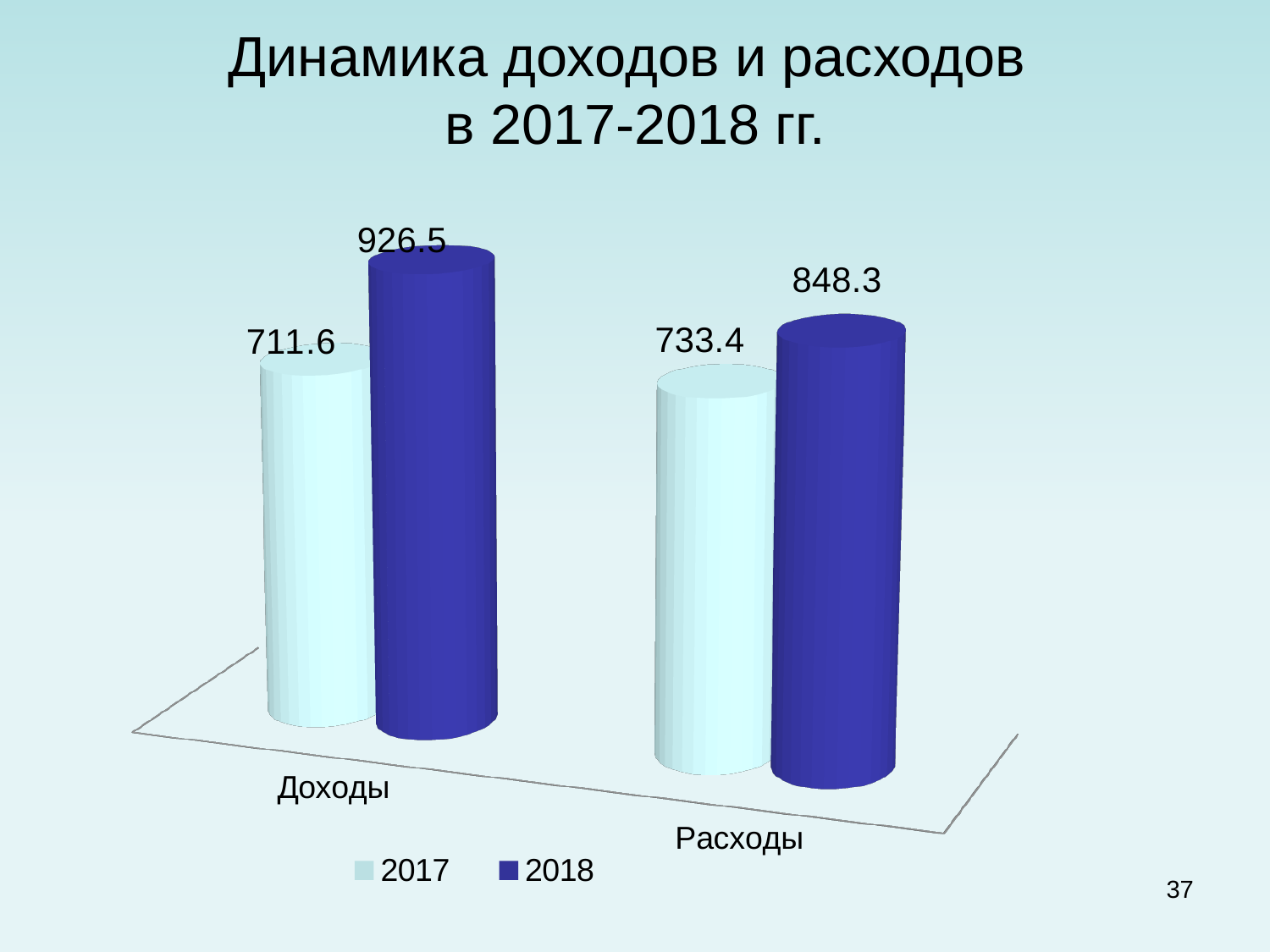
Which bar has the highest value on the chart? Доходы 2018 How many categories are shown on the x axis? 2 Which bar has the lowest value on the chart? Доходы 2017 What is the value for Расходы in 2018? 848.3 What is the value for Расходы in 2017? 733.4 What is the difference between Доходы in 2018 and Доходы in 2017? 214.9 How many series does the legend list? 2 What kind of chart is shown on the slide? Bar chart Which is larger in 2017: Доходы or Расходы? Расходы What is the value for Доходы in 2017? 711.6 What is the value for Доходы in 2018? 926.5 What is the difference between Расходы in 2018 and Расходы in 2017? 114.9